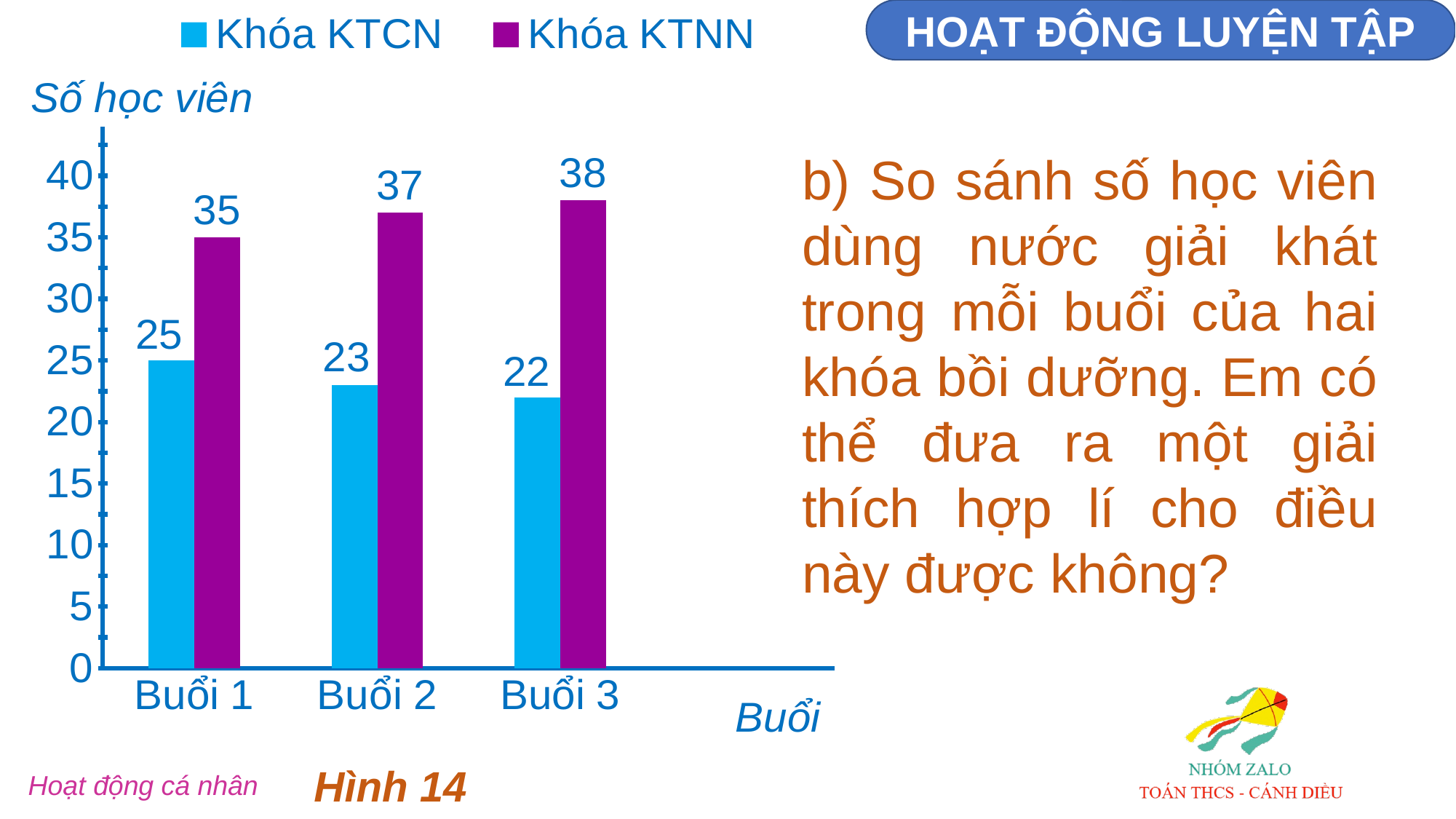
What is the difference between Khóa KTNN and Khóa KTCN in Buổi 3? 16 In which session (Buổi) is the Khóa KTCN value lowest? Buổi 3 Which is larger in Buổi 2: Khóa KTCN or Khóa KTNN? Khóa KTNN What is the difference between Khóa KTNN and Khóa KTCN in Buổi 1? 10 What is the value for Khóa KTCN in Buổi 1? 25 How many sessions (categories) are shown on the x axis? 3 Do the Khóa KTCN values rise or fall from Buổi 1 to Buổi 3? Fall What is the value for Khóa KTNN in Buổi 2? 37 In which session (Buổi) is the Khóa KTNN value highest? Buổi 3 What is the value for Khóa KTNN in Buổi 3? 38 What kind of chart is shown? Bar chart How many series does the legend list? 2